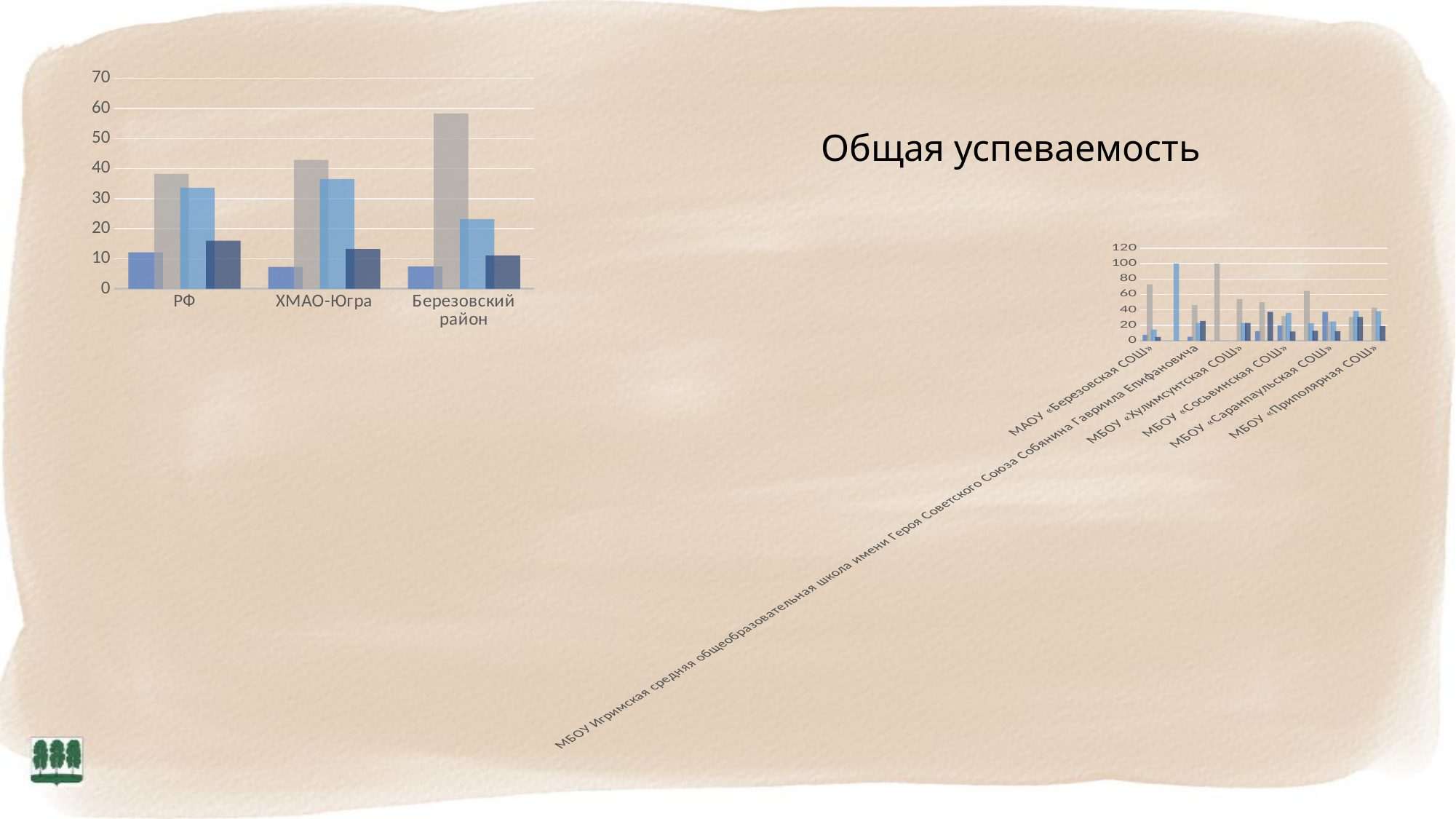
How many categories are shown on the x axis of the left chart? 3 What is the highest value shown on the y axis of the right chart? 120 In the left chart, which has a taller tallest bar: РФ or Березовский район? Березовский район What is the highest value shown on the y axis of the left chart? 70 In the left chart, which category contains the tallest bar? Березовский район In the right chart, is the tallest bar for МБОУ «Сосьвинская СОШ» greater or less than 80? less How many categories are shown on the x axis of the right chart? 11 In the left chart, is the tallest bar for Березовский район greater or less than 50? greater In the right chart, is the tallest bar for МАОУ «Березовская СОШ» greater or less than 60? greater What kind of chart is the chart on the left of the slide? bar chart